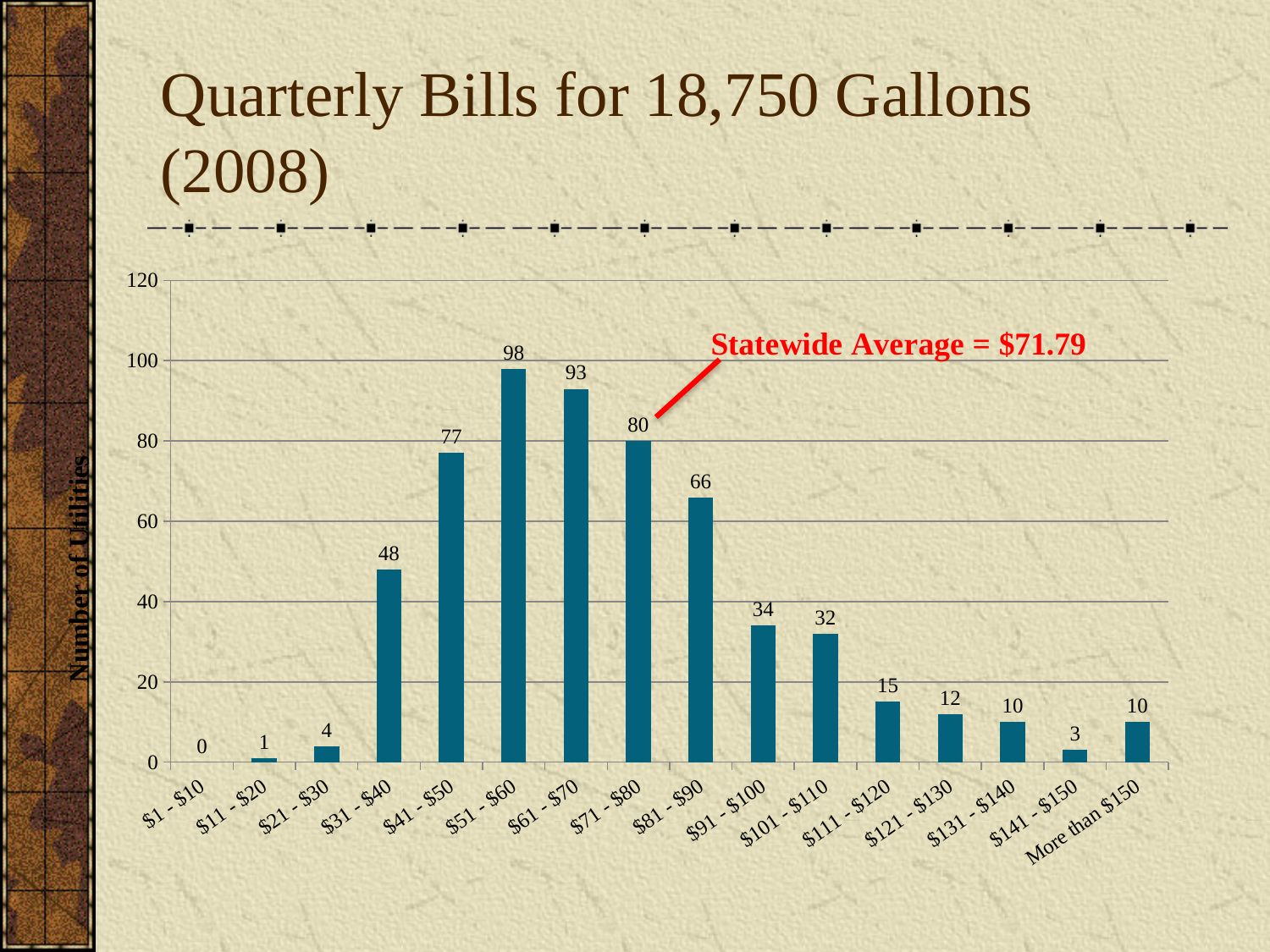
How many bill-range categories are shown on the x axis? 16 What statewide average is annotated on the chart? $71.79 What is the label of the y axis? Number of Utilities What is the difference between the number of utilities in the $61 - $70 range and the $71 - $80 range? 13 What kind of chart is shown on the slide? Bar chart Do the values rise or fall from the $51 - $60 category to the $141 - $150 category? Fall How many utilities fall in the 'More than $150' category? 10 Which has more utilities: the $91 - $100 range or the $101 - $110 range? $91 - $100 Which bill range has the lowest number of utilities? $1 - $10 What is the number of utilities for the $31 - $40 category? 48 How many utilities had a quarterly bill in the $51 - $60 range? 98 Which bill range has the highest number of utilities? $51 - $60